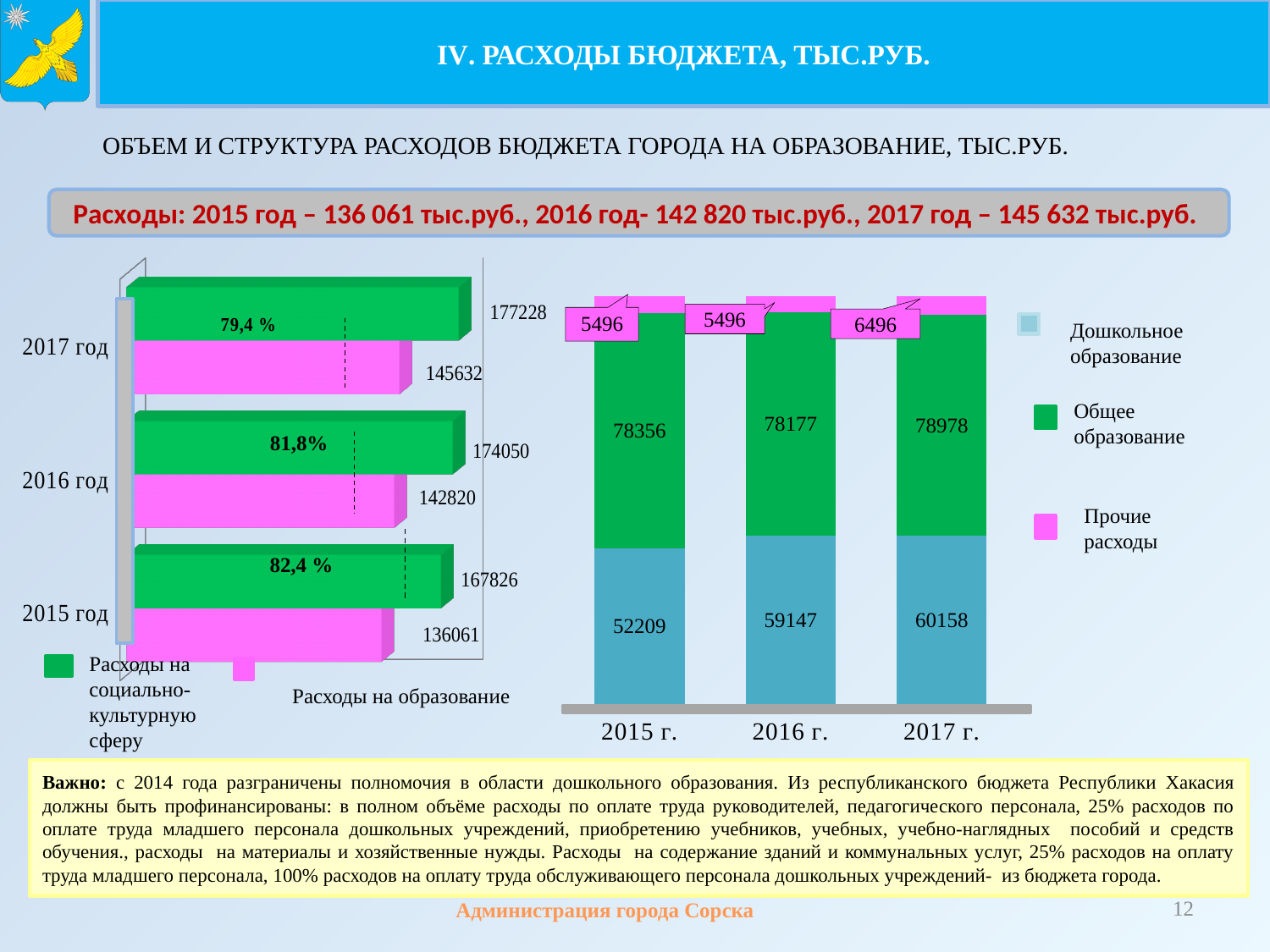
На левой диаграмме, каково значение расходов на социально-культурную сферу за 2015 год? 167826 На левой диаграмме, в каком году расходы на образование были наименьшими? 2015 год На левой диаграмме, на сколько расходы на социально-культурную сферу за 2016 год превышают расходы на образование за тот же год? 31230 На левой диаграмме, какого типа эта диаграмма? Столбчатая (bar chart) На правой диаграмме, каково значение общего образования за 2016 г.? 78177 На правой диаграмме, что больше: дошкольное образование за 2016 г. или за 2015 г.? 2016 г. На правой диаграмме, какова сумма всех сегментов столбца за 2015 г.? 136061 На левой диаграмме, какой процент указан для 2016 года? 81,8% На правой диаграмме, как изменяются значения дошкольного образования с 2015 г. по 2017 г.? Растут На правой диаграмме, сколько серий перечислено в легенде? 3 На правой диаграмме, каково значение дошкольного образования за 2017 г.? 60158 На левой диаграмме, каково значение расходов на образование за 2017 год? 145632